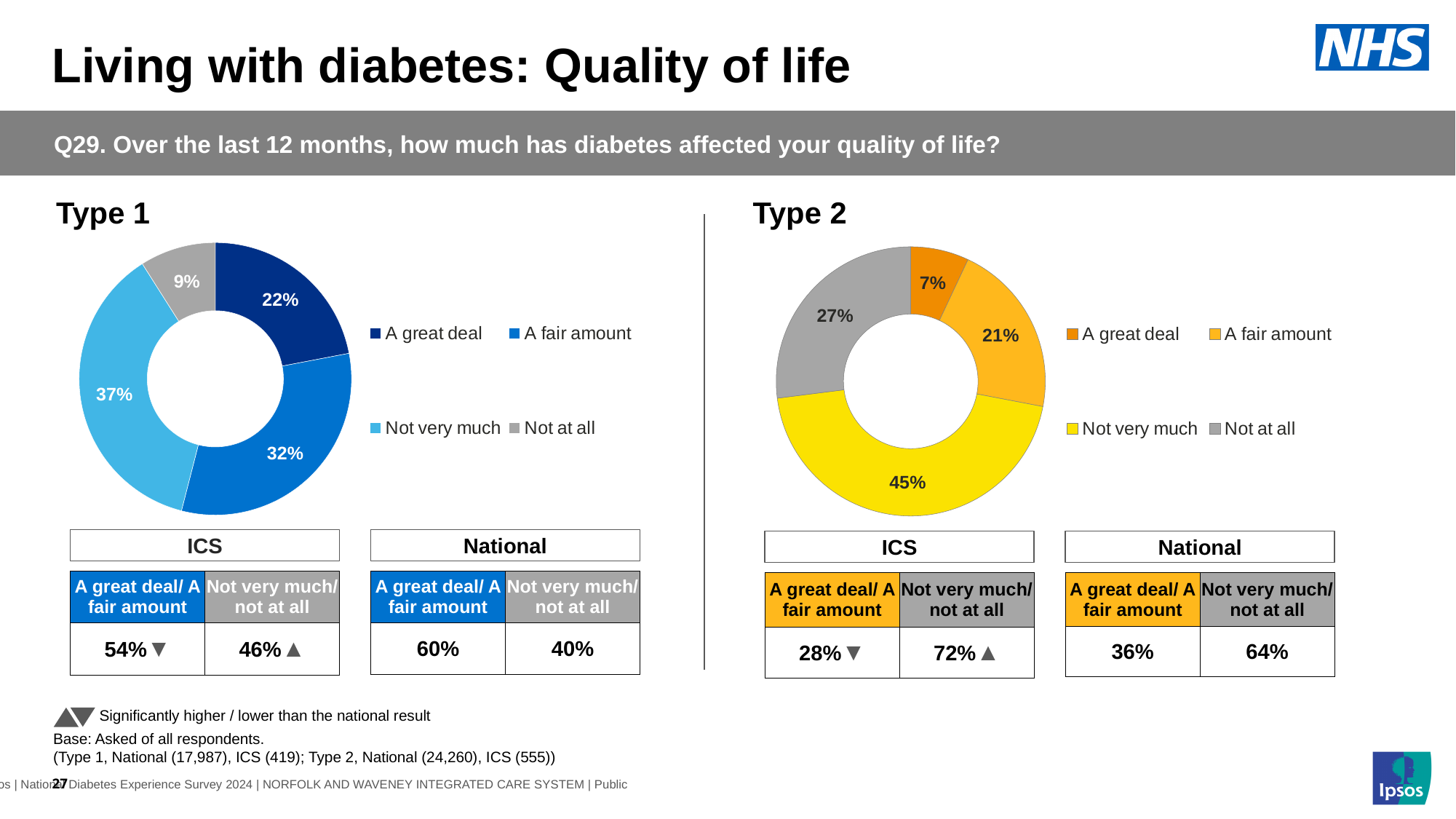
In the Type 2 chart, which category has the largest share? Not very much In the Type 2 chart, what is the value for 'A fair amount'? 21% In the Type 1 chart, what is the difference between 'Not very much' and 'A fair amount'? 5 percentage points In the Type 1 chart, what is the value for 'Not very much'? 37% In the Type 1 chart, which category has the smallest share? Not at all Which is larger: 'A great deal' in the Type 1 chart or 'A great deal' in the Type 2 chart? Type 1 In the Type 1 chart, what percentage of respondents said diabetes affected their quality of life 'A great deal'? 22% How many categories does the Type 2 chart show? 4 In the Type 2 chart, what is the value for 'Not at all'? 27% In the Type 2 chart, what is the difference between 'Not very much' and 'Not at all'? 18 percentage points In the Type 2 chart, which category has the smallest share? A great deal What type of chart is used for Type 1? Donut (pie) chart